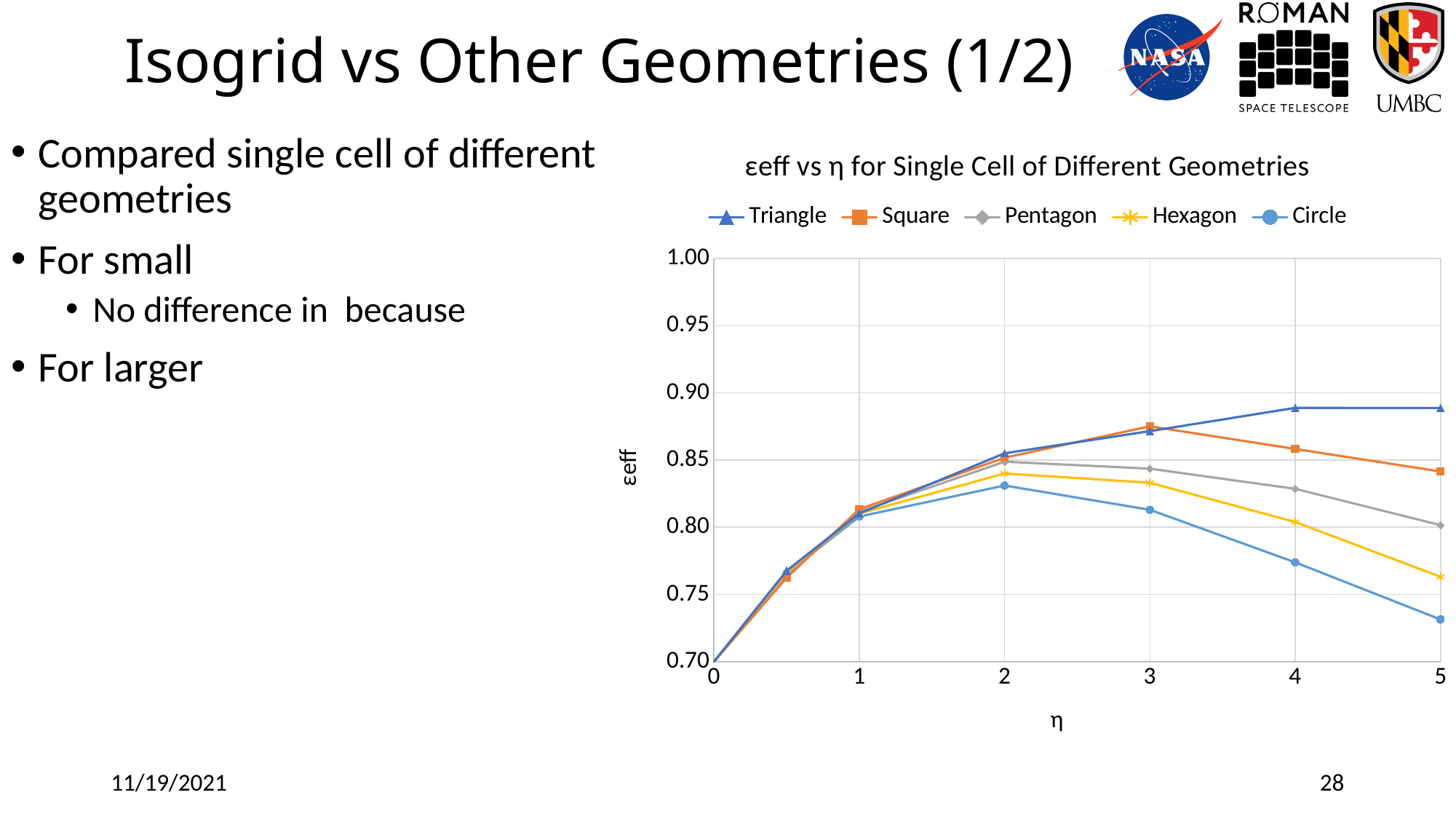
Which series has the highest εeff at η = 5? Triangle Is the εeff value for Triangle at η = 5 greater or less than 0.90? less What is the label of the y axis? εeff Does the εeff value for Circle rise or fall between η = 2 and η = 5? Fall Is the εeff value for Square at η = 5 greater or less than 0.85? less Does the εeff value for Triangle rise or fall between η = 0 and η = 4? Rise What kind of chart is shown on the slide? Line chart Is the εeff value for Circle at η = 5 greater or less than 0.75? less At η = 4, which series has the larger εeff, Square or Pentagon? Square Which series has the lowest εeff at η = 5? Circle How many series does the legend list? 5 What is the title of the chart? εeff vs η for Single Cell of Different Geometries